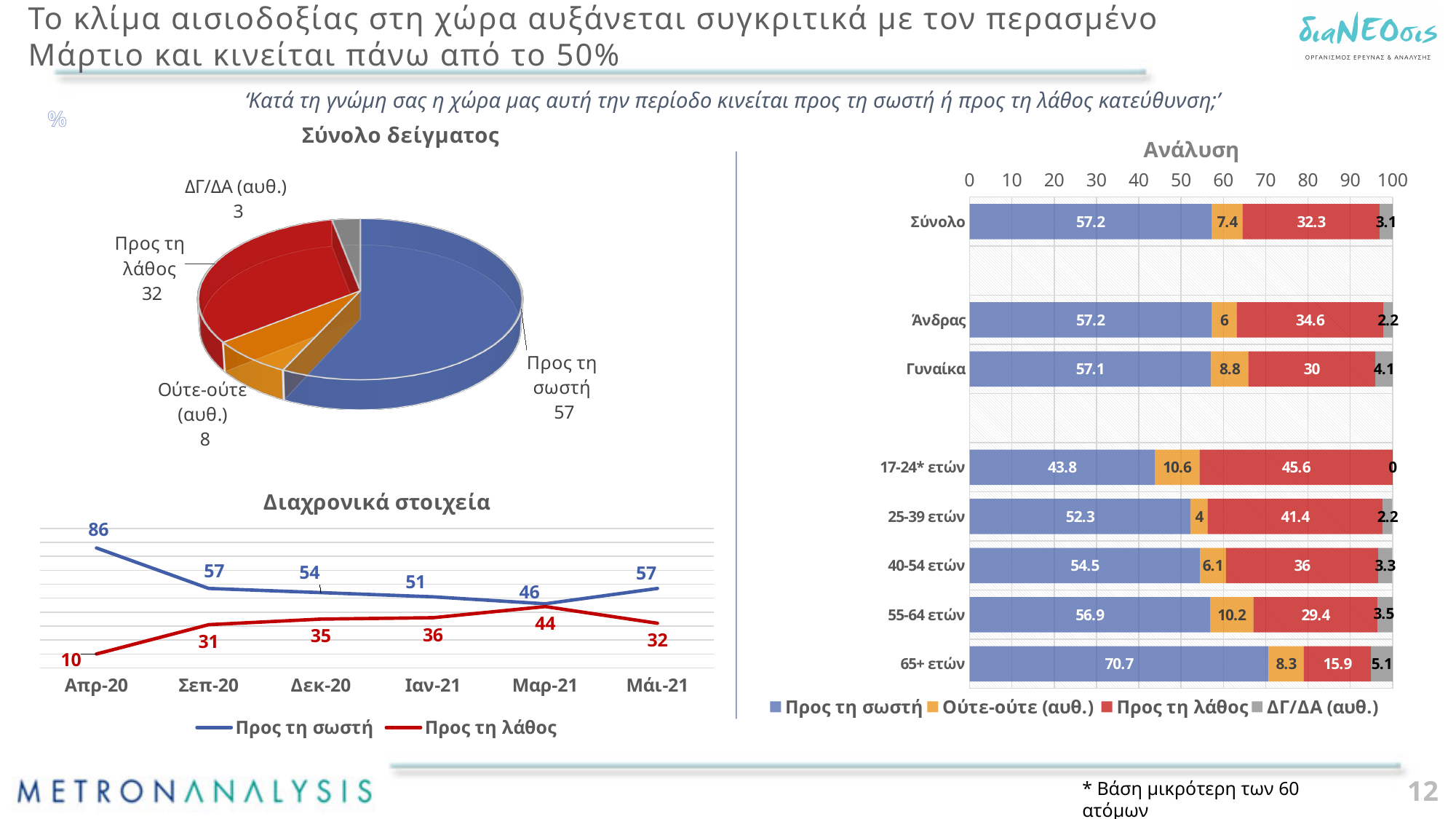
In the line chart 'Διαχρονικά στοιχεία', what is the value of 'Προς τη σωστή' for Απρ-20? 86 In the line chart 'Διαχρονικά στοιχεία', what is the difference between 'Προς τη σωστή' and 'Προς τη λάθος' for Μάι-21? 25 In the line chart 'Διαχρονικά στοιχεία', does 'Προς τη λάθος' rise or fall from Απρ-20 to Μαρ-21? rise In the bar chart 'Ανάλυση', what is the value of 'Προς τη σωστή' for '65+ ετών'? 70.7 In the bar chart 'Ανάλυση', how many series does the legend list? 4 In the pie chart 'Σύνολο δείγματος', what is the value for 'Προς τη σωστή'? 57 In the bar chart 'Ανάλυση', which is larger: 'Ούτε-ούτε (αυθ.)' for 'Άνδρας' or for 'Γυναίκα'? Γυναίκα In the pie chart 'Σύνολο δείγματος', which slice is the smallest? ΔΓ/ΔΑ (αυθ.) In the line chart 'Διαχρονικά στοιχεία', how many series does the legend list? 2 What kind of chart is 'Ανάλυση'? stacked bar chart In the bar chart 'Ανάλυση', which category has the highest value for 'Προς τη λάθος'? 17-24* ετών In the pie chart 'Σύνολο δείγματος', how many slices are there? 4